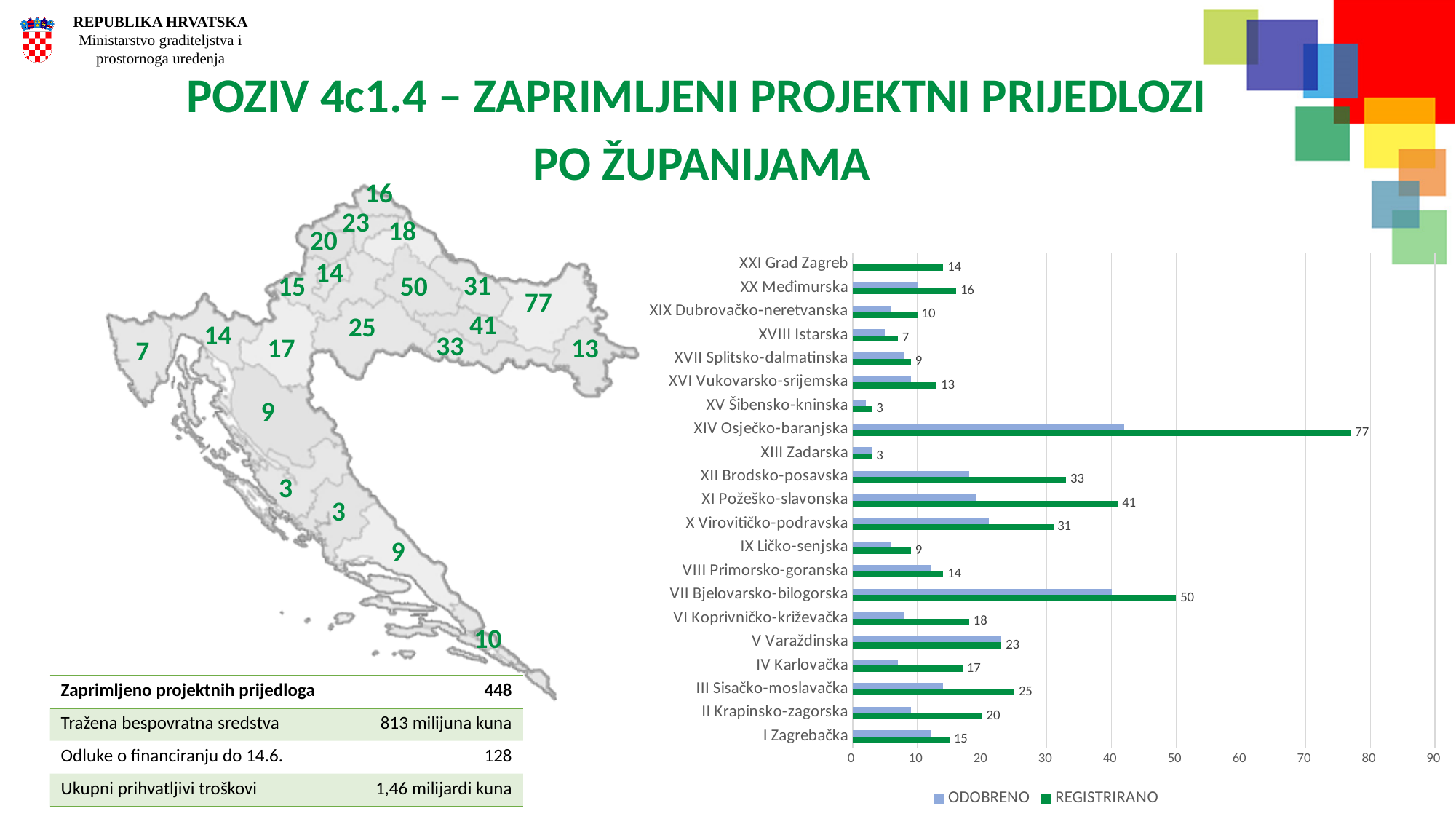
What is the difference between the REGISTRIRANO values for XI Požeško-slavonska and XII Brodsko-posavska? 8 Is the ODOBRENO value for XV Šibensko-kninska greater or less than 10? less What are the two series named in the chart legend? ODOBRENO and REGISTRIRANO What is the REGISTRIRANO value for VII Bjelovarsko-bilogorska? 50 What is the REGISTRIRANO value for I Zagrebačka? 15 How many series does the chart legend list? 2 Which county has the highest REGISTRIRANO value? XIV Osječko-baranjska Which has a larger REGISTRIRANO value, V Varaždinska or III Sisačko-moslavačka? III Sisačko-moslavačka How many counties (categories) are shown on the chart? 21 What kind of chart is shown on the slide? bar chart Is the ODOBRENO value for XIV Osječko-baranjska greater or less than 40? greater What is the REGISTRIRANO value for XIV Osječko-baranjska? 77